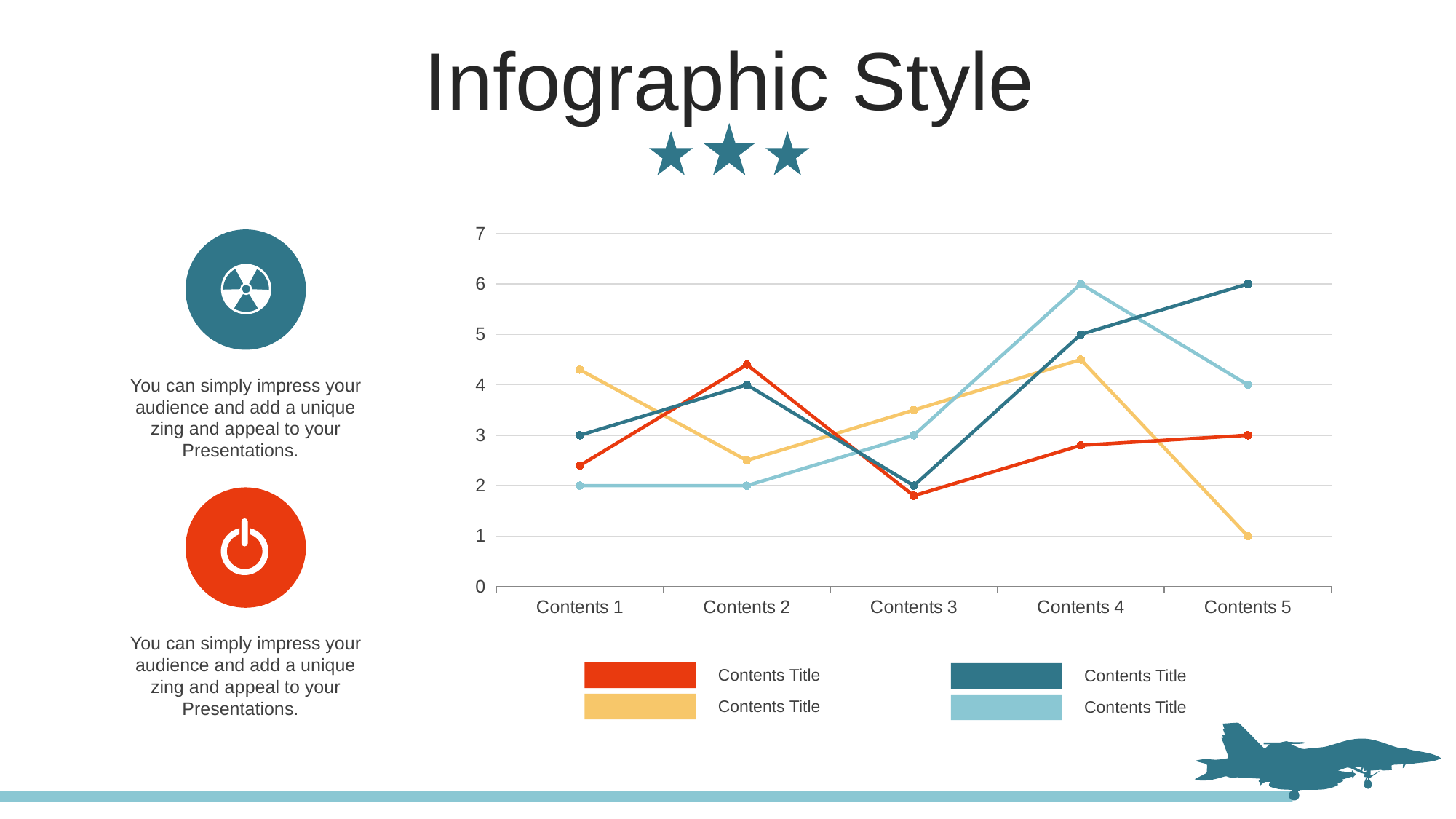
At which category does the dark teal line reach its highest value? Contents 5 What is the value of the yellow line at Contents 5? 1 What kind of chart is shown on the slide? line chart What is the value of the dark teal line at Contents 1? 3 What is the value of the light blue line at Contents 4? 6 How many series does the chart's legend list? 4 At Contents 4, which line has the larger value: the light blue line or the dark teal line? light blue line How many categories are shown on the x axis of the chart? 5 What is the value of the dark teal line at Contents 5? 6 What is the difference between the dark teal line's value at Contents 5 and at Contents 1? 3 Is the value of the red line at Contents 2 greater or less than 4? greater At which category does the yellow line reach its lowest value? Contents 5